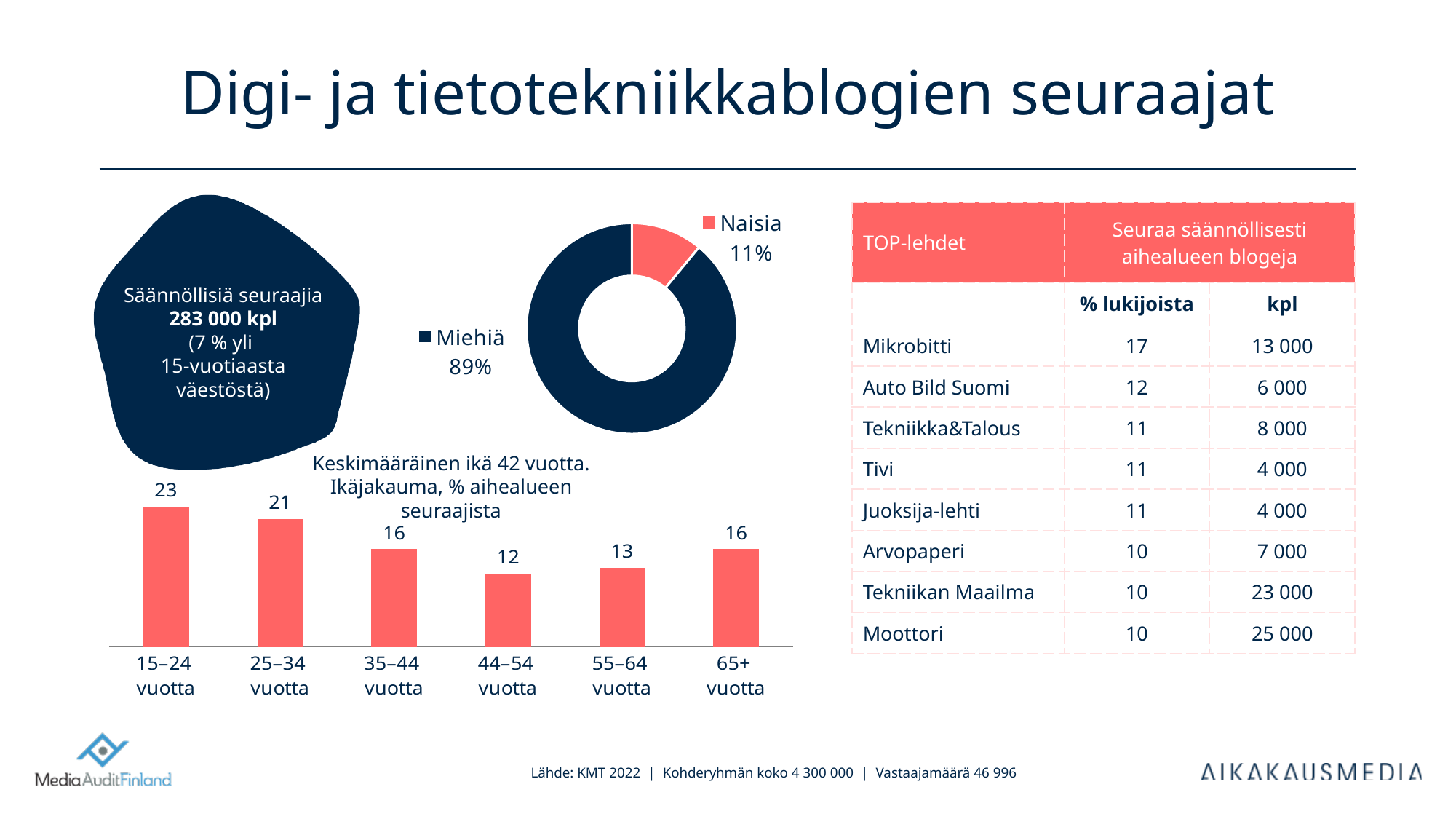
How many segments does the donut chart have? 2 In the age distribution bar chart, what is the value for 15–24 vuotta? 23 What type of chart shows the age distribution at the bottom left of the slide? Bar chart In the age distribution bar chart, what is the difference between the values for 15–24 vuotta and 65+ vuotta? 7 In the age distribution bar chart, which is larger, the value for 25–34 vuotta or 55–64 vuotta? 25–34 vuotta In the age distribution bar chart, what is the value for 44–54 vuotta? 12 In the age distribution bar chart, which age group has the lowest value? 44–54 vuotta How many age groups are shown in the age distribution bar chart? 6 In the donut chart, which segment is larger, Miehiä or Naisia? Miehiä In the donut chart, what share is labelled Naisia? 11% In the age distribution bar chart, which age group has the highest value? 15–24 vuotta In the donut chart, what share is labelled Miehiä? 89%